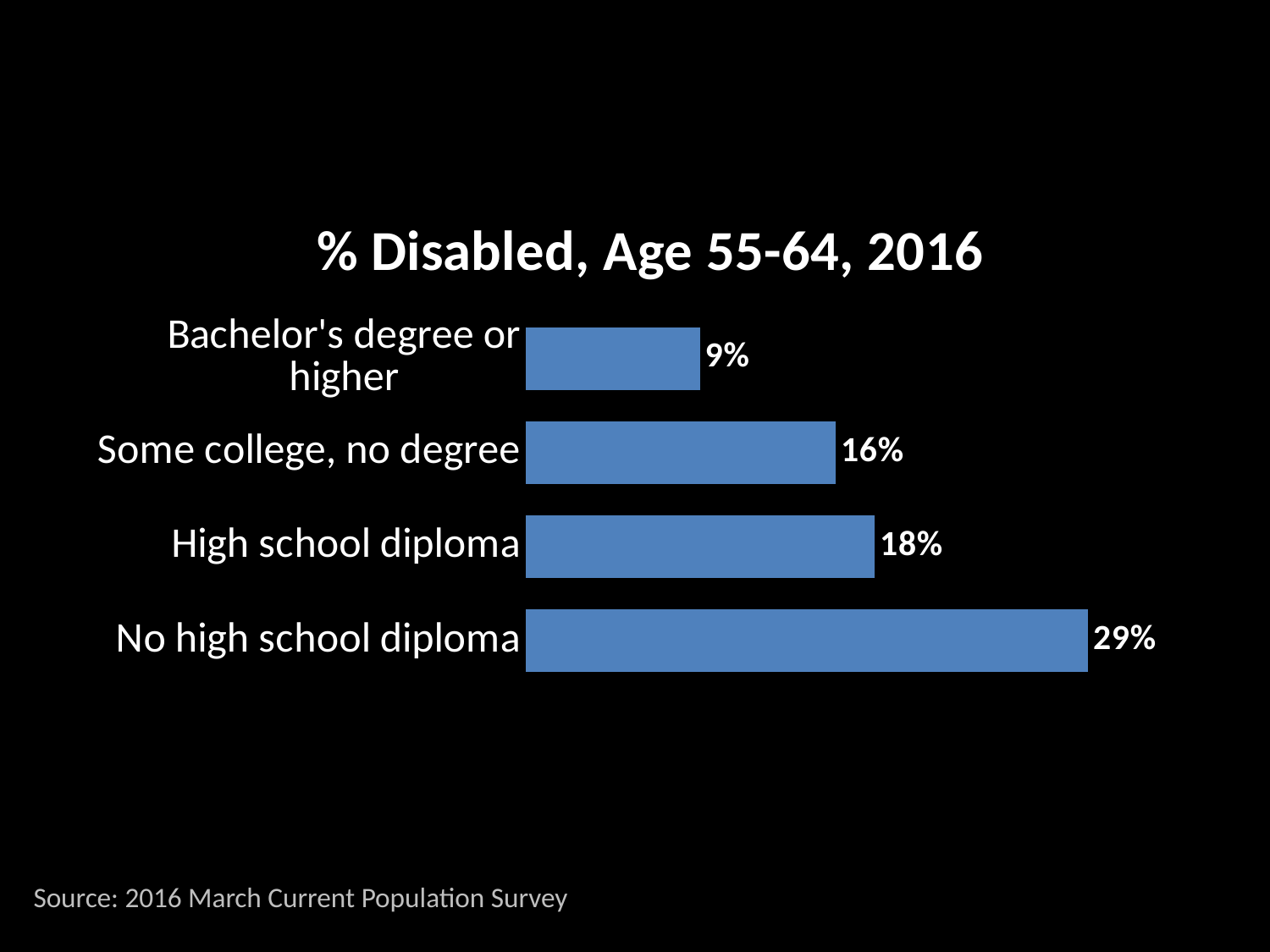
Which category has the highest value? No high school diploma Which is larger, the value for High school diploma or the value for Some college, no degree? High school diploma How many categories are shown in the chart? 4 What kind of chart is shown on the slide? Bar chart What is the difference between the values for High school diploma and Some college, no degree? 2% What is the title of the chart? % Disabled, Age 55-64, 2016 What is the value for Some college, no degree? 16% What is the value for High school diploma? 18% What is the difference between the values for No high school diploma and Bachelor's degree or higher? 20% Which category has the lowest value? Bachelor's degree or higher What is the value for No high school diploma? 29% What is the value for Bachelor's degree or higher? 9%